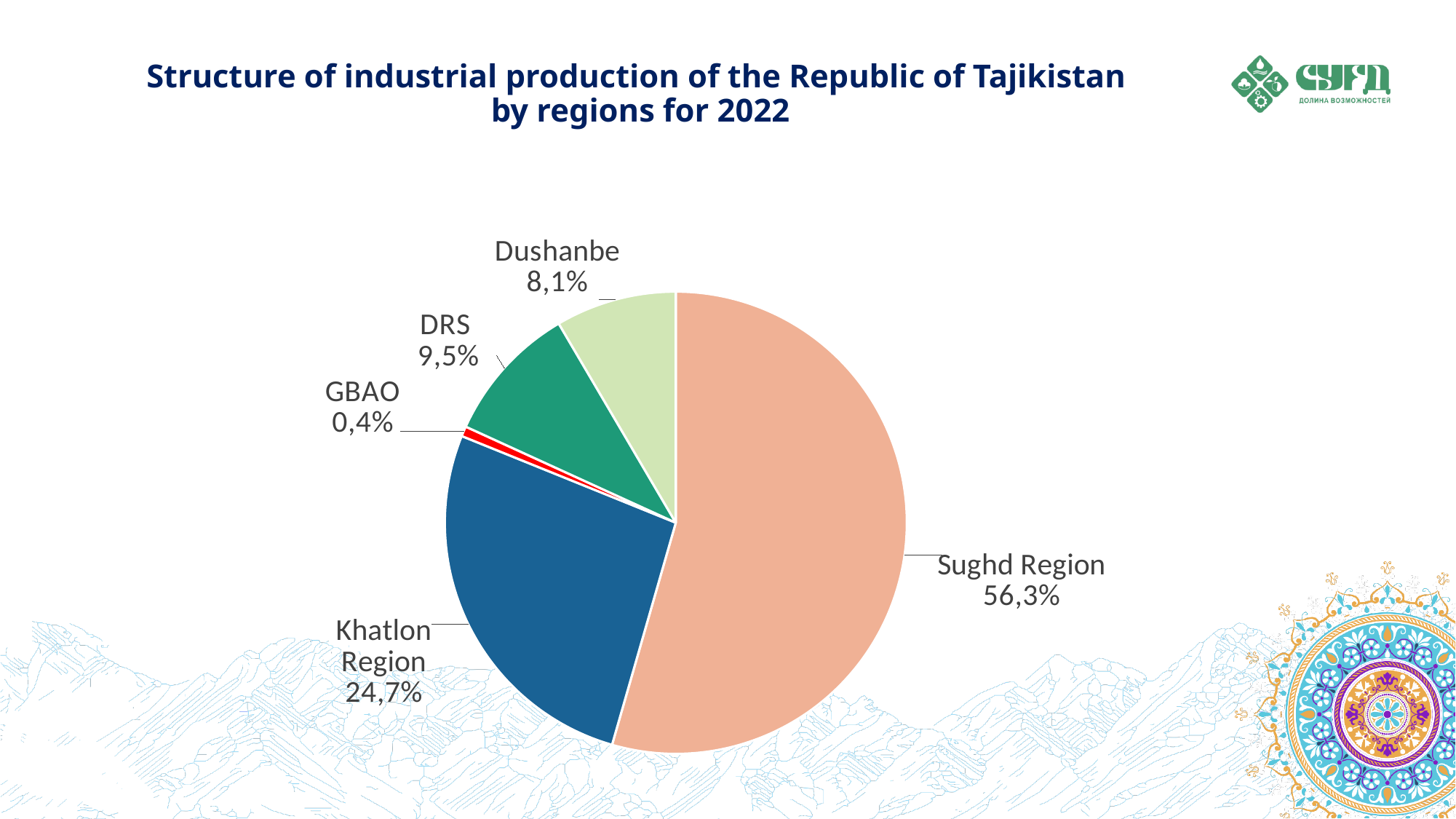
What share of industrial production does Sughd Region account for? 56,3% What is the value shown for GBAO? 0,4% What type of chart is shown on the slide? Pie chart Which region has the smallest share of industrial production? GBAO What is the value shown for DRS? 9,5% What share of industrial production does Khatlon Region account for? 24,7% What is the difference between the shares of Sughd Region and Khatlon Region? 31,6% What is the title of the chart? Structure of industrial production of the Republic of Tajikistan by regions for 2022 Which region has the largest share of industrial production? Sughd Region How many regions are shown in the pie chart? 5 Which has a larger share, DRS or Dushanbe? DRS What is the value shown for Dushanbe? 8,1%